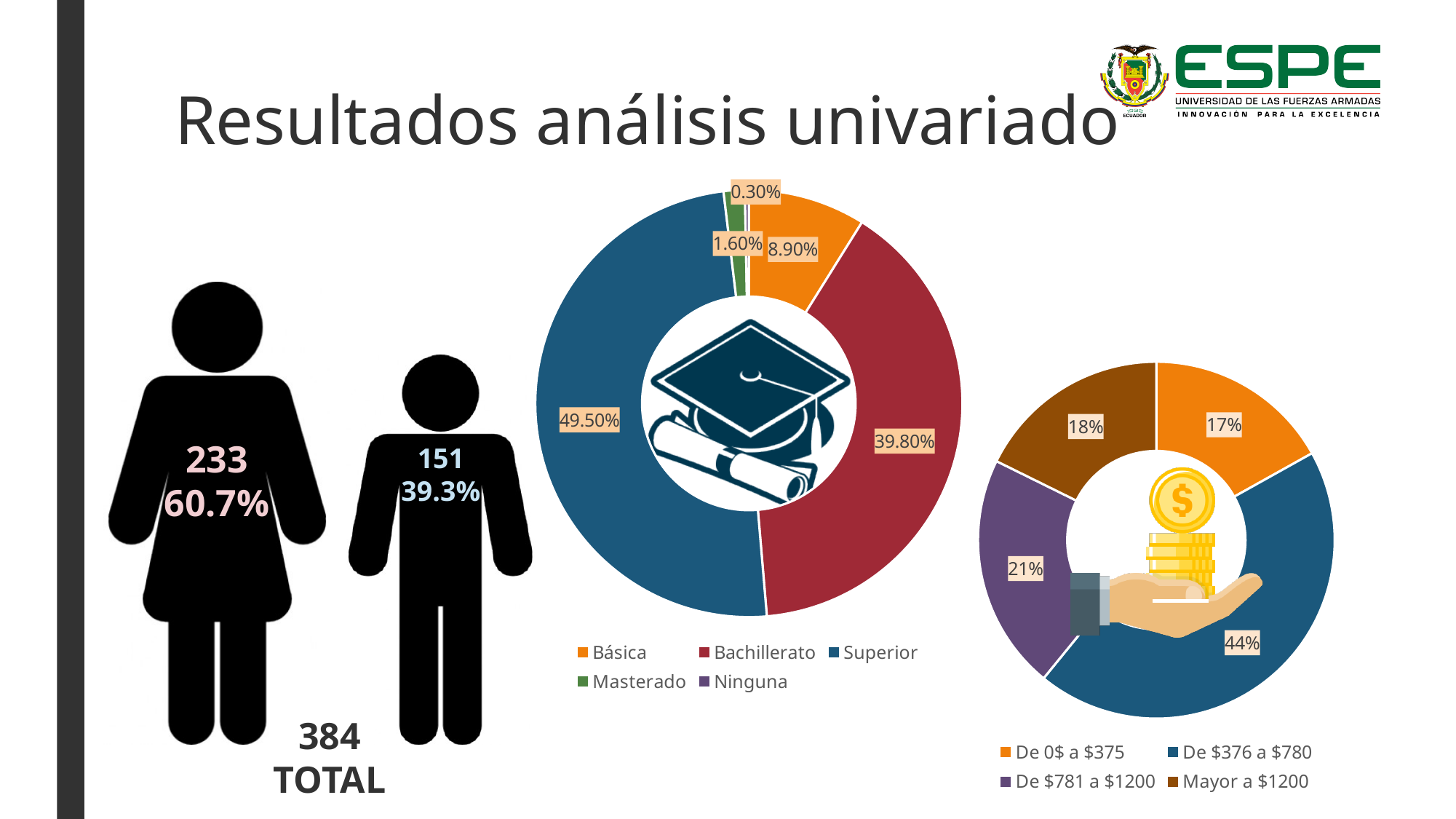
In the education-level doughnut chart (middle), which category has the smallest share? Ninguna What type of chart is the income chart on the right of the slide? Doughnut chart In the income doughnut chart (right), what percentage is shown for De $376 a $780? 44% In the education-level doughnut chart (middle), which category has the largest share? Superior In the education-level doughnut chart (middle), what colour represents Masterado? Green In the income doughnut chart (right), which is larger: De 0$ a $375 or Mayor a $1200? Mayor a $1200 In the education-level doughnut chart (middle), how many categories does the legend list? 5 In the education-level doughnut chart (middle), what is the difference between the Superior and Bachillerato percentages? 9.70% In the income doughnut chart (right), what percentage is shown for De $781 a $1200? 21% In the income doughnut chart (right), which category has the largest share? De $376 a $780 In the education-level doughnut chart (middle), what percentage is shown for Superior? 49.50% In the education-level doughnut chart (middle), what percentage is shown for Bachillerato? 39.80%